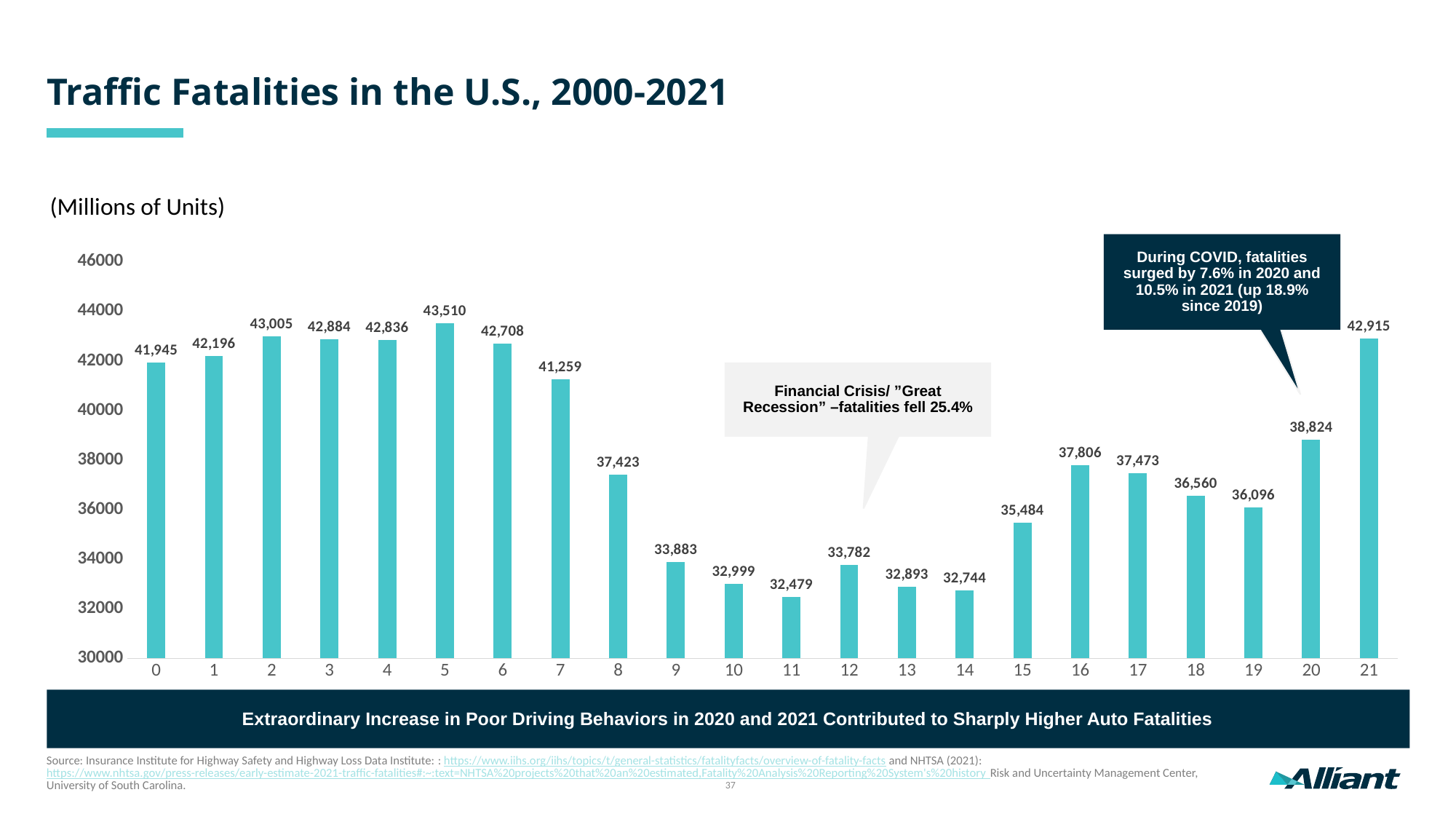
What is the value of the bar labelled 11 on the x axis? 32,479 What is the value of the bar labelled 21 on the x axis? 42,915 What type of chart is shown on the slide? bar chart What is the title of the slide's chart? Traffic Fatalities in the U.S., 2000-2021 Do the values rise or fall from the bar labelled 7 to the bar labelled 11? fall Is the value for the bar labelled 8 greater or less than 38000? less Which x-axis category has the lowest value? 11 Which x-axis category has the highest value? 5 What is the value of the bar labelled 5 on the x axis? 43,510 How many bars are plotted in the chart? 22 What is the difference between the values for the bars labelled 21 and 20? 4,091 Which is larger, the value for the bar labelled 16 or the bar labelled 17? 16